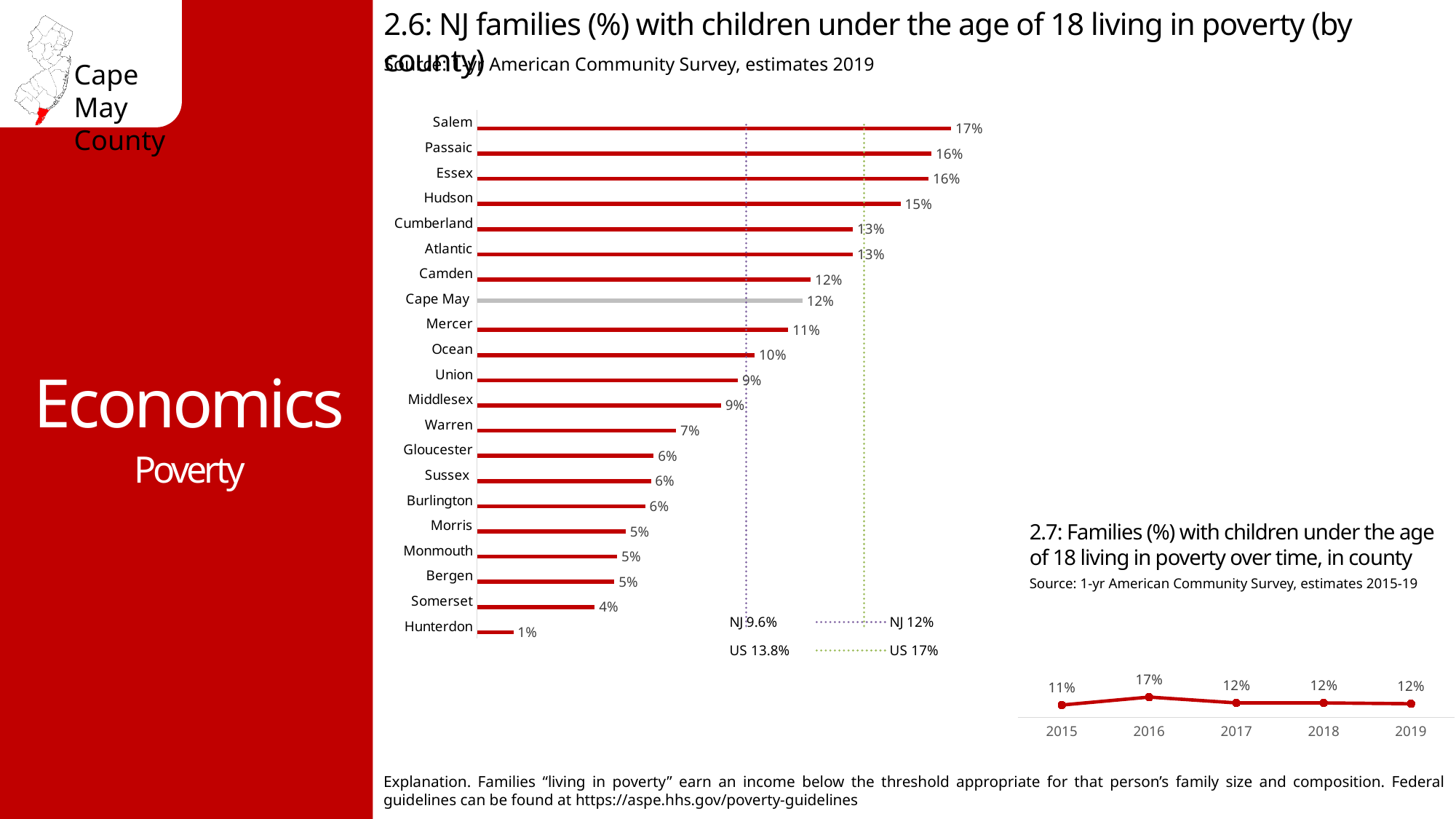
In chart 2.7, how many years are plotted? 5 What kind of chart is chart 2.6? Bar chart In chart 2.6, how many counties are shown? 21 In chart 2.6, what is the value for Hudson? 15% In chart 2.7, which year has the highest value? 2016 In chart 2.6, which county has the lowest percentage of families with children living in poverty? Hunterdon In chart 2.7 (families with children under 18 living in poverty over time), what is the value for 2016? 17% In chart 2.6, which has a higher value, Warren or Somerset? Warren In chart 2.6, what is the difference between the values for Salem and Hunterdon? 16 percentage points In chart 2.6, which county has the highest percentage of families with children living in poverty? Salem In chart 2.6 (NJ families with children under 18 living in poverty by county), what is the value for Cape May? 12%